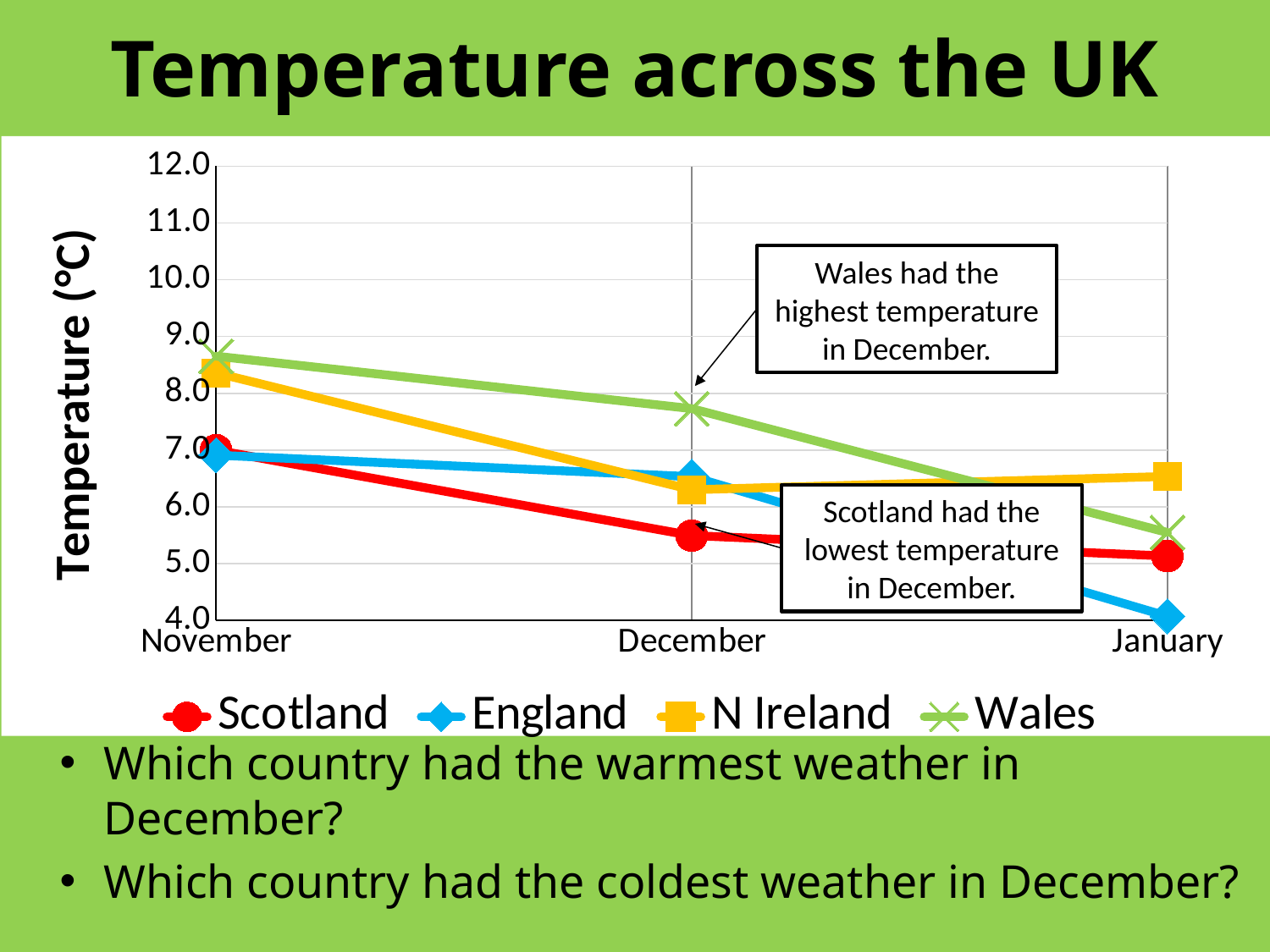
Does the temperature for Scotland rise or fall from November to January? fall Which country had the lowest temperature in January? England Is the value for England in January greater or less than 5.0? less How many months are shown along the x axis? 3 How many series does the legend list? 4 Which country had the highest temperature in December? Wales Which country had the lowest temperature in December? Scotland What kind of chart is shown on the slide? line chart In January, which is higher: Scotland or England? Scotland Is the value for Wales in December greater or less than 7.0? greater Is the value for Scotland in December greater or less than 6.0? less What is the label on the y axis? Temperature (°C)